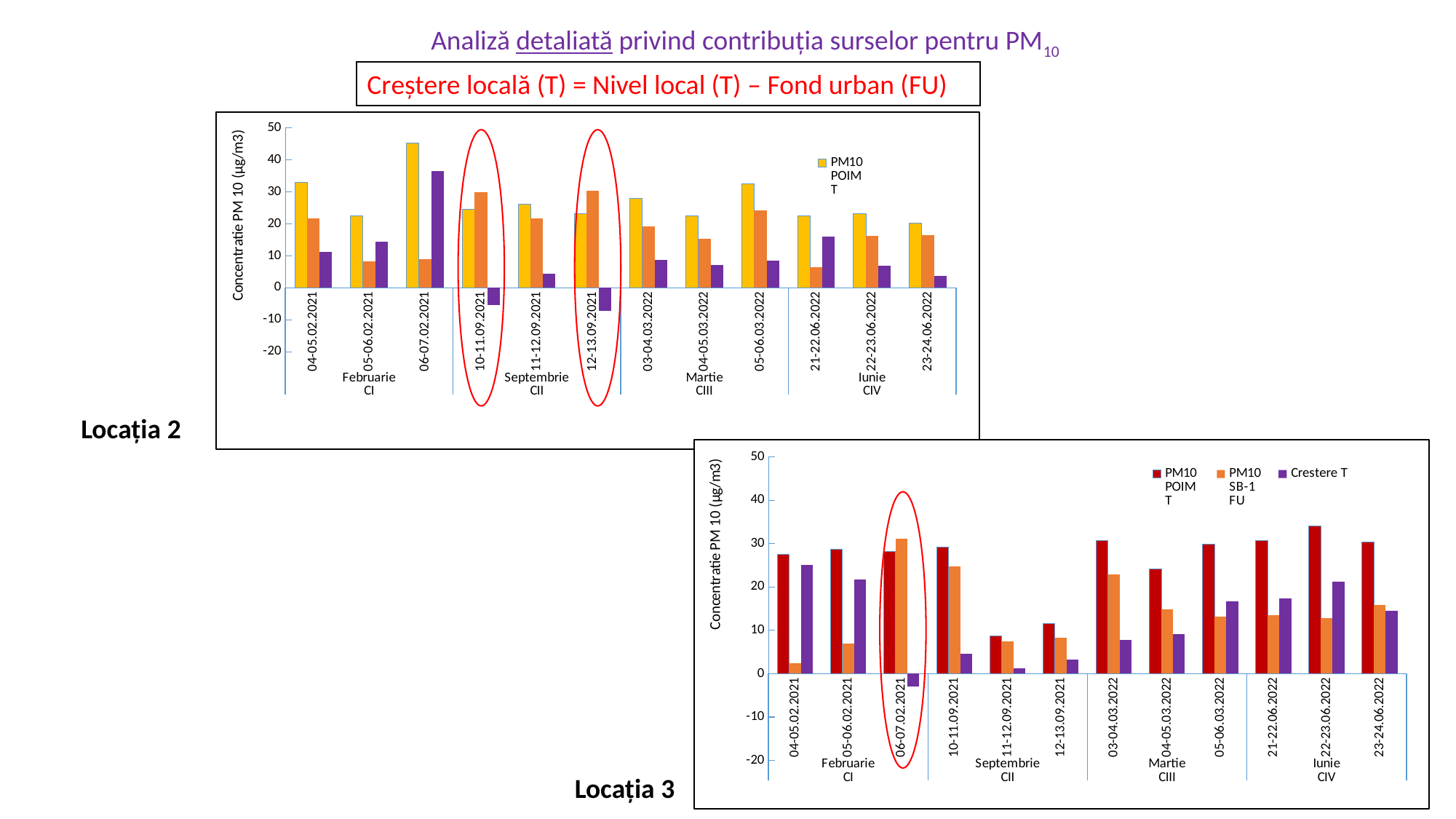
What kind of chart is the Locația 2 chart? bar chart How many series does the legend of the Locația 3 chart list? 3 In the Locația 2 chart, is the PM10 POIM T value for 06-07.02.2021 greater or less than 40? greater In the Locația 3 chart, on which date is the PM10 POIM T value highest? 22-23.06.2022 In the Locația 2 chart, on which date is the PM10 POIM T value highest? 06-07.02.2021 In the Locația 3 chart, on which date is the PM10 SB-1 FU value lowest? 04-05.02.2021 In the Locația 3 chart, is the PM10 POIM T value for 22-23.06.2022 greater or less than 30? greater How many dates are shown on the x axis of the Locația 2 chart? 12 How many dates are shown on the x axis of the Locația 3 chart? 12 In the Locația 3 chart, for 06-07.02.2021, which is larger: PM10 POIM T or PM10 SB-1 FU? PM10 SB-1 FU In the Locația 3 chart, on which date is the Crestere T value highest? 04-05.02.2021 In the Locația 3 chart, on which date is the PM10 POIM T value lowest? 11-12.09.2021